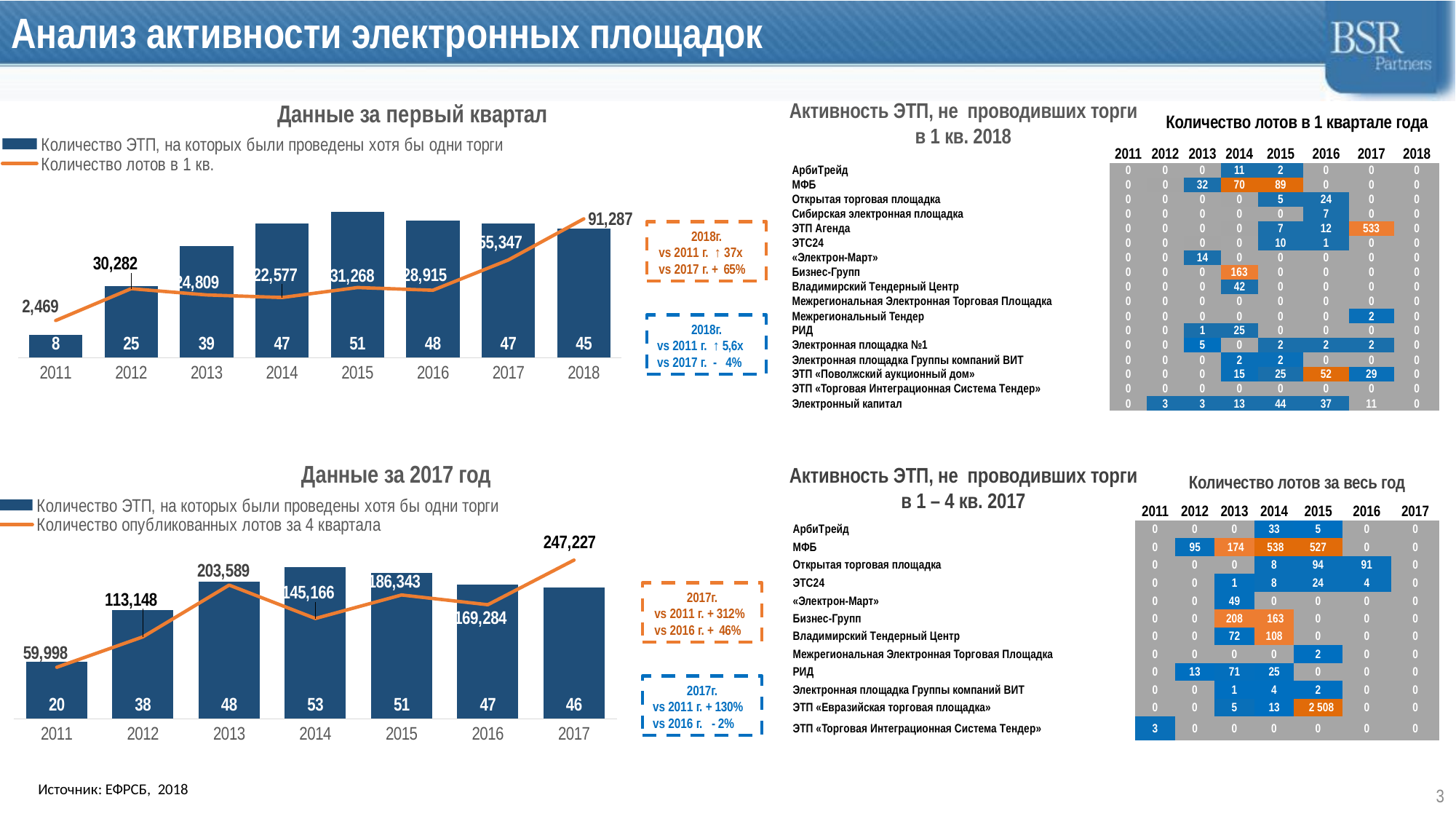
In the chart 'Данные за первый квартал', which year has the highest number of ЭТП with at least one auction? 2015 In the chart 'Данные за 2017 год', what is the number of ЭТП with at least one auction in 2014? 53 How many series does the legend of the chart 'Данные за 2017 год' list? 2 In the chart 'Данные за первый квартал', how many years are shown on the x axis? 8 In the chart 'Данные за первый квартал', what is the difference between the number of lots in Q1 2018 and Q1 2017? 35,940 In the chart 'Данные за 2017 год', which is larger: the number of published lots in 2014 or in 2016? 2016 In the chart 'Данные за 2017 год', which year has the highest number of published lots? 2017 In the chart 'Данные за первый квартал', which year has the lowest number of lots in Q1? 2011 In the chart 'Данные за первый квартал', what is the number of lots in Q1 2018? 91,287 In the chart 'Данные за первый квартал', what is the number of ЭТП with at least one auction in 2015? 51 In the chart 'Данные за 2017 год', what is the number of published lots for 4 quarters in 2013? 203,589 In the chart 'Данные за 2017 год', what is the difference between the number of ЭТП in 2012 and in 2011? 18